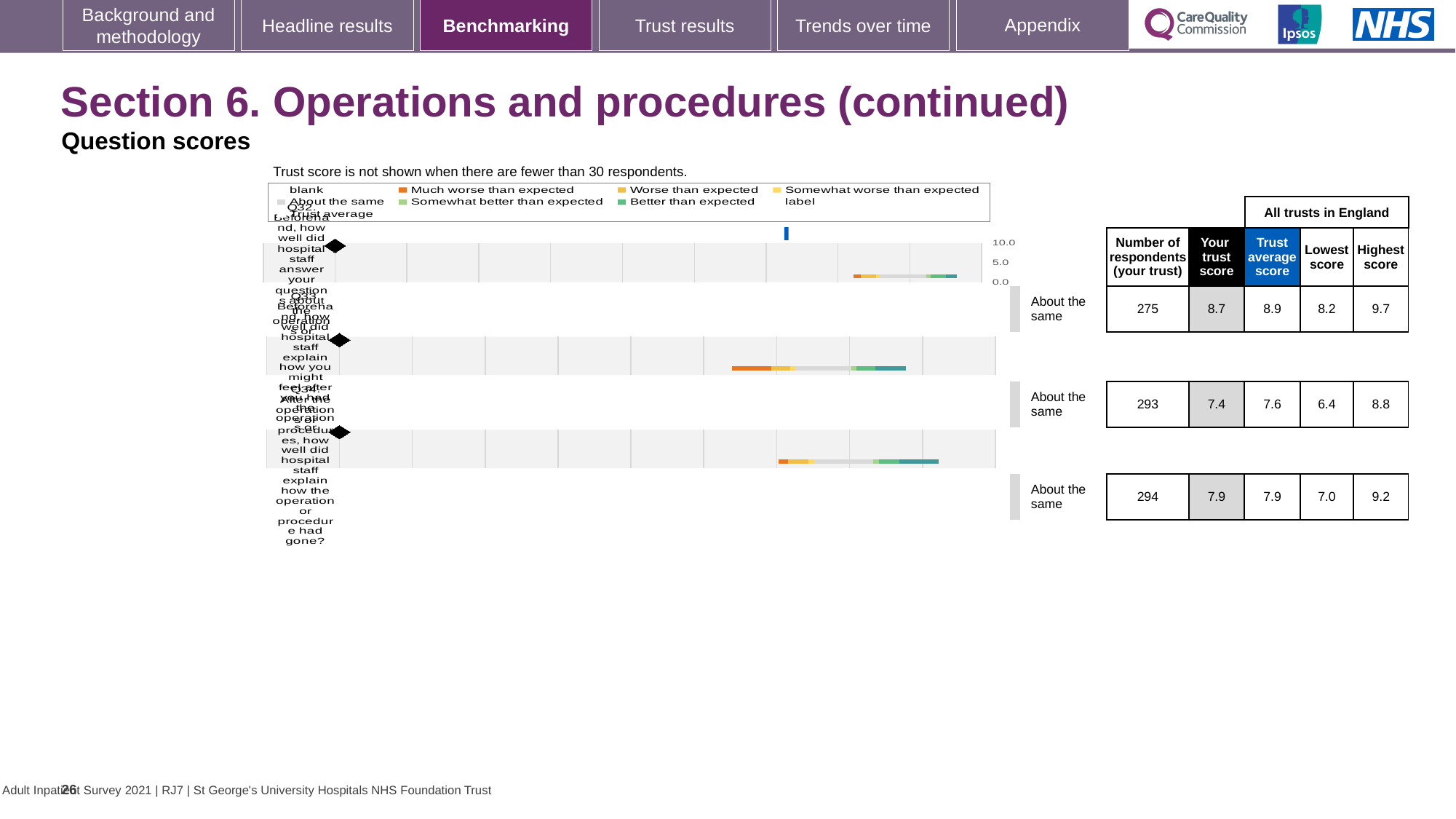
Is your trust score for the second question row larger or smaller than the trust average score for that row? smaller What is the difference between the highest score and the lowest score for the first question row (Q32)? 1.5 What kind of chart is shown on the slide? bar chart In the table, what is the lowest score for the third question row? 7.0 In the table, what is the number of respondents for the first question row (Q32)? 275 In the table, what is the highest score for the second question row? 8.8 Which legend entry is shown in orange? Much worse than expected In the table, what is your trust score for the first question row (Q32)? 8.7 What is the highest value shown on the chart's score axis? 10.0 Which question row has the highest 'Your trust score' in the table? the first row (Q32) In the table, what is the trust average score for the second question row? 7.6 How many question rows (bars) does the chart show? 3